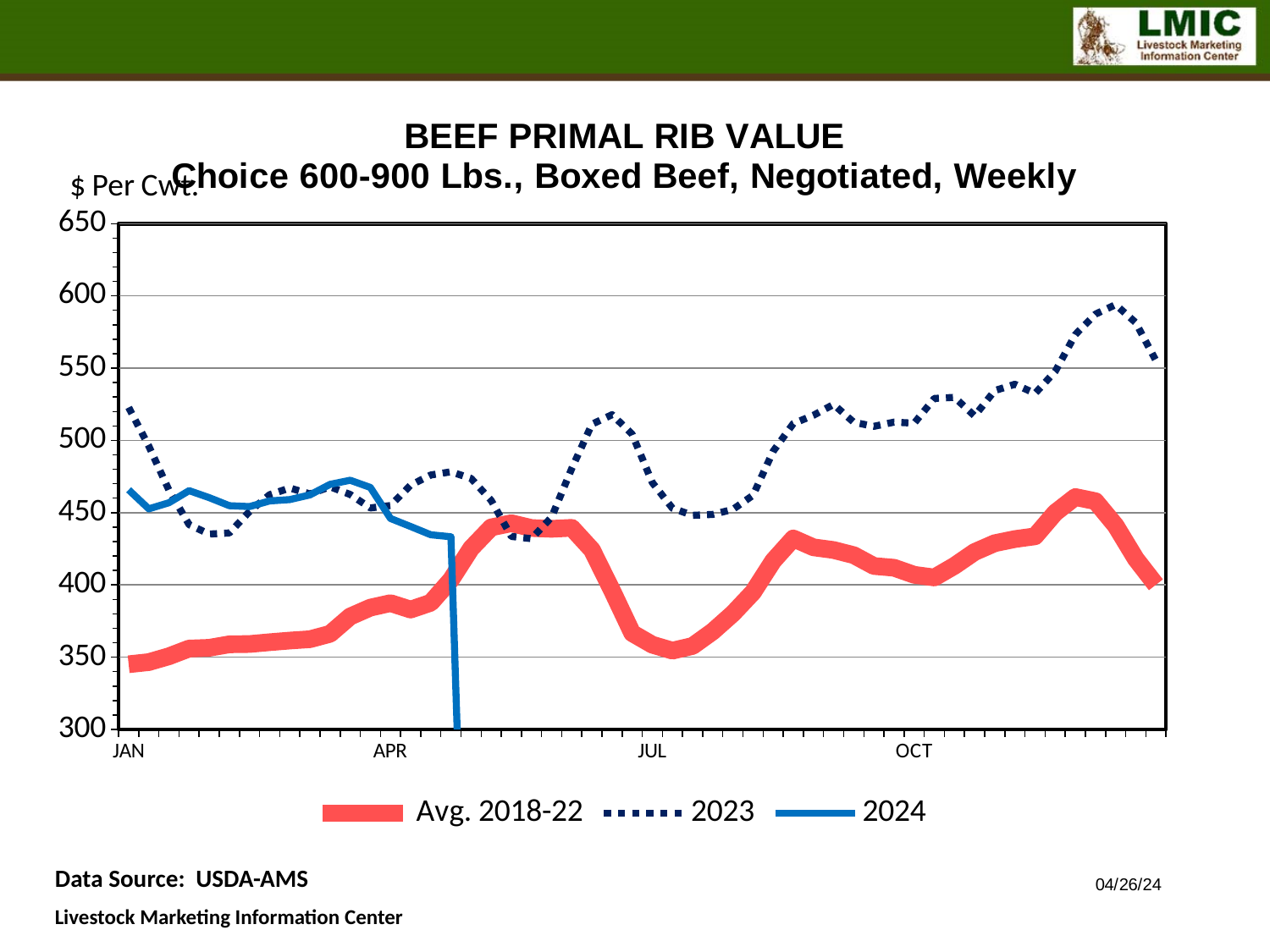
Is the 2023 value in JAN greater or less than 500? greater Does the Avg. 2018-22 line rise or fall from JAN to APR? rise What is the label on the y axis of the chart? $ Per Cwt. In JAN, which series has the higher value: 2023 or Avg. 2018-22? 2023 Is the Avg. 2018-22 value in JAN greater or less than 400? less How many series does the legend list? 3 Is the highest 2023 value on the chart greater or less than 550? greater What are the three series listed in the legend? Avg. 2018-22, 2023, 2024 What kind of chart is shown on the slide? Line chart Which series reaches the highest value anywhere on the chart? 2023